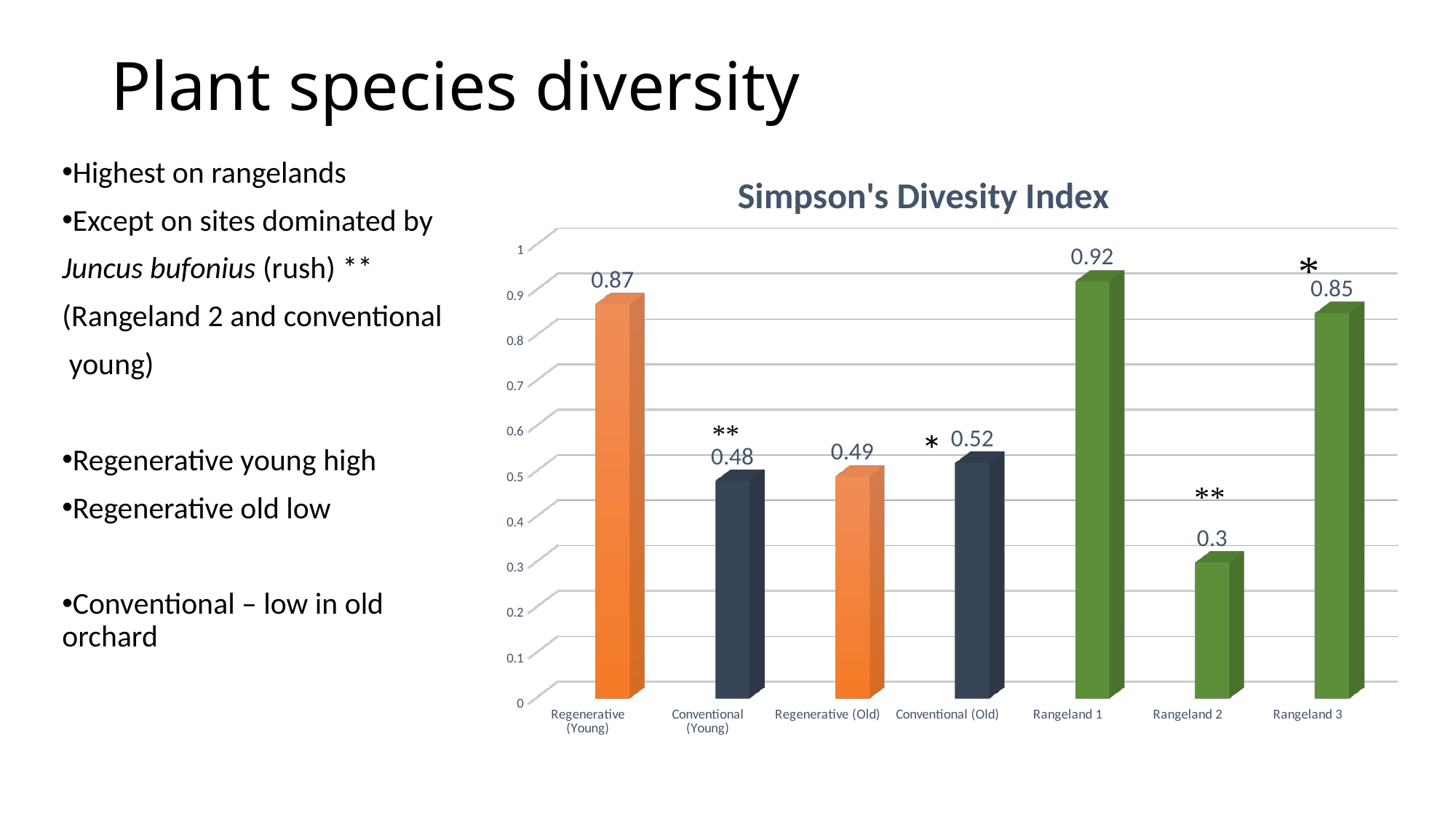
Which is larger, the value for Rangeland 3 or the value for Conventional (Old)? Rangeland 3 Which category has the lowest Simpson's Diversity Index? Rangeland 2 What kind of chart is shown on the slide? Bar chart What is the difference between the values for Regenerative (Young) and Regenerative (Old)? 0.38 What is the value shown for Regenerative (Young)? 0.87 What is the title of the chart? Simpson's Divesity Index What is the value shown for Rangeland 2? 0.3 Which category has the highest Simpson's Diversity Index? Rangeland 1 What is the Simpson's Diversity Index value for Rangeland 1? 0.92 What is the difference between the values for Rangeland 1 and Rangeland 2? 0.62 How many categories are shown on the x axis of the chart? 7 What is the value shown for Conventional (Old)? 0.52